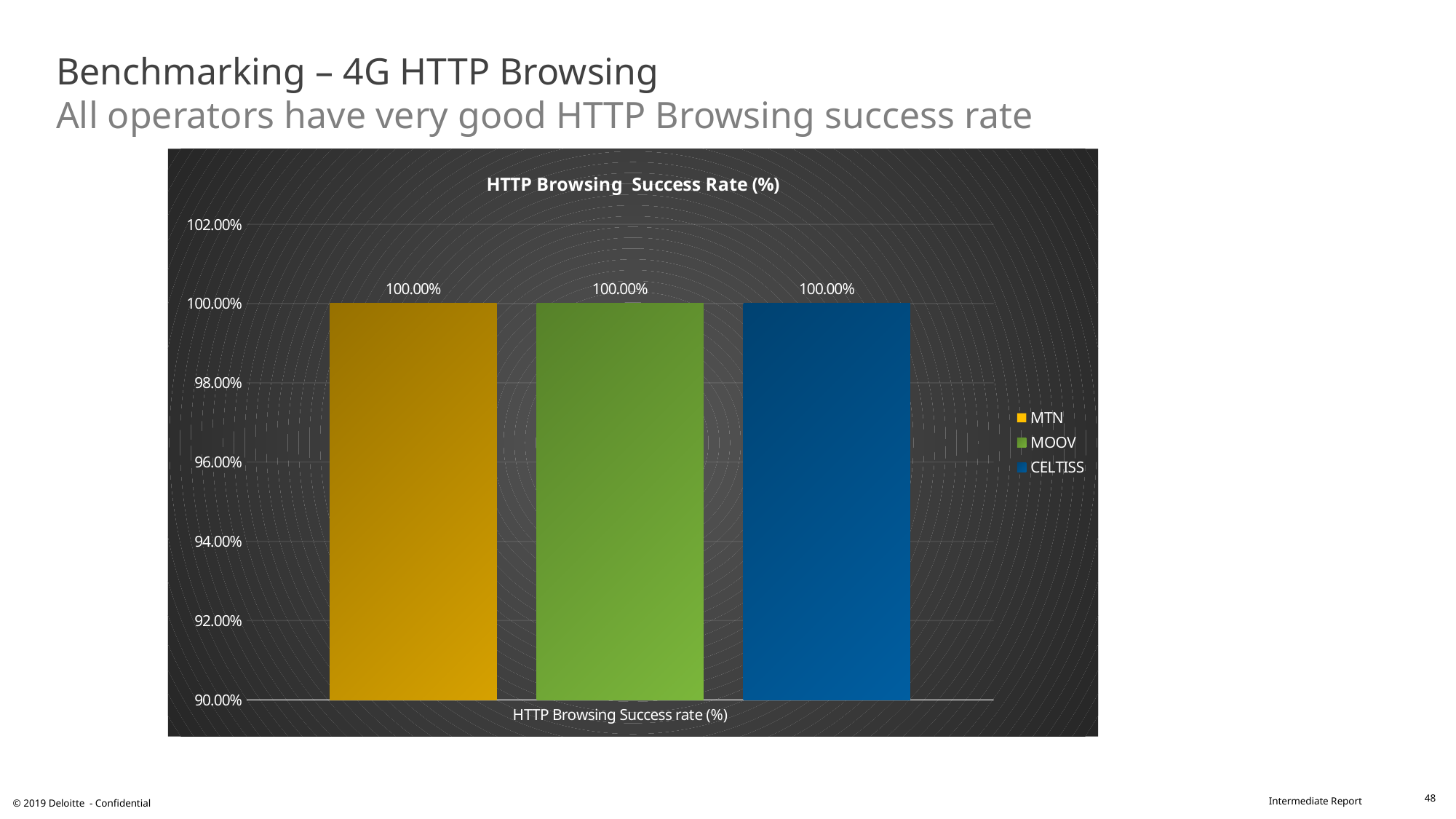
Which operator is represented by the blue bar? CELTISS What kind of chart is shown on the slide? Bar chart What is the title of the chart? HTTP Browsing Success Rate (%) What is the difference between the HTTP Browsing Success Rate of MTN and CELTISS? 0.00% What is the HTTP Browsing Success Rate for CELTISS? 100.00% What is the HTTP Browsing Success Rate for MTN? 100.00% How many series does the legend list? 3 Is the HTTP Browsing Success Rate for MOOV greater or less than 98.00%? greater How many bars are plotted in the chart? 3 Is the HTTP Browsing Success Rate for CELTISS greater or less than 102.00%? less What is the HTTP Browsing Success Rate for MOOV? 100.00%